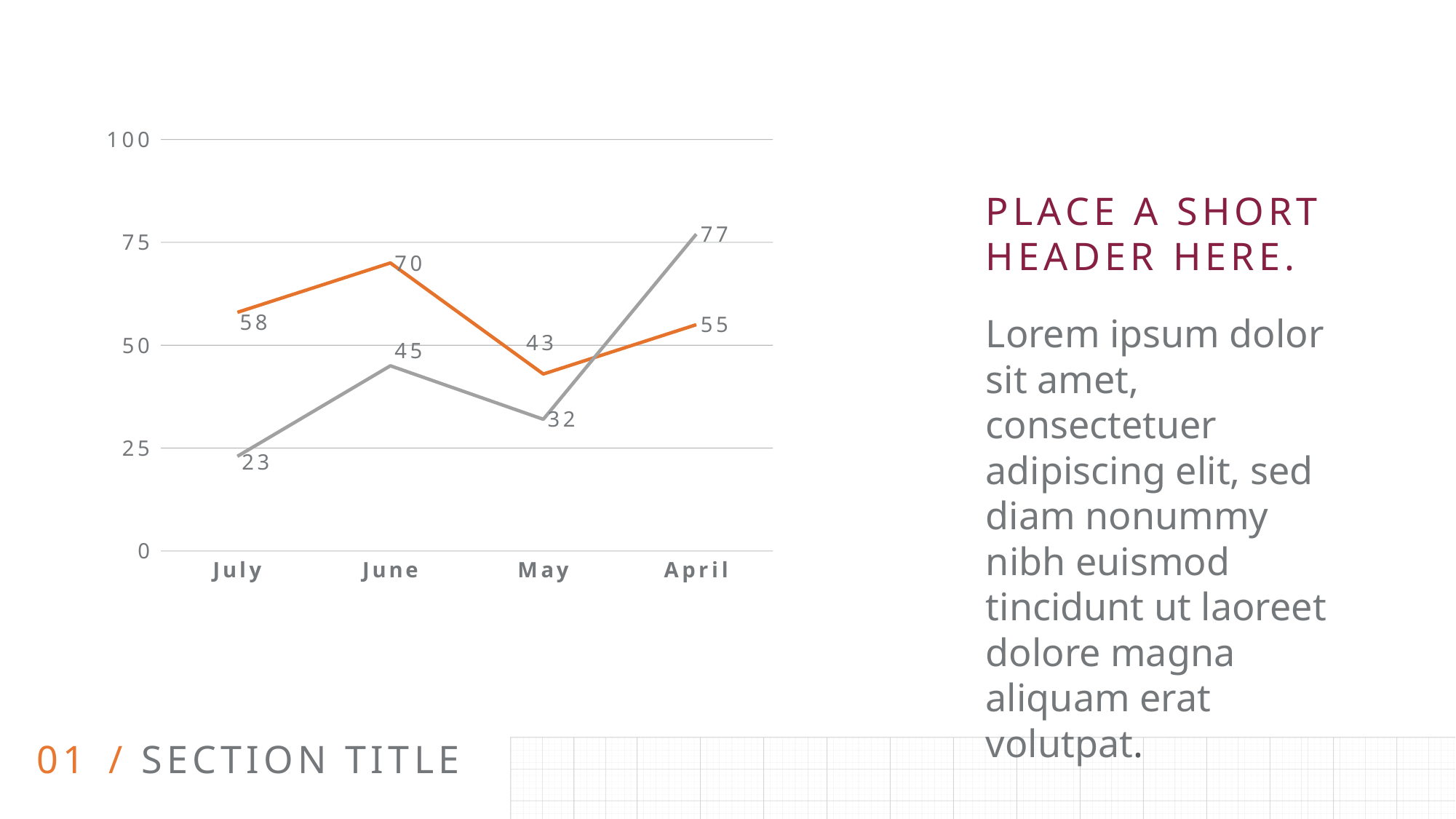
What is the difference between the orange line and the gray line in July? 35 How many categories are shown on the x axis of the chart? 4 What is the value of the gray line for April? 77 Is the value of the gray line for May greater or less than 50? less What is the value of the orange line for June? 70 Which line has the larger value in April, the orange line or the gray line? gray line Does the gray line rise or fall from May to April? rise In which category does the orange line have its lowest value? May What type of chart is shown on the slide? line chart What is the value of the orange line for May? 43 In which category does the gray line reach its highest value? April What is the value of the gray line for July? 23